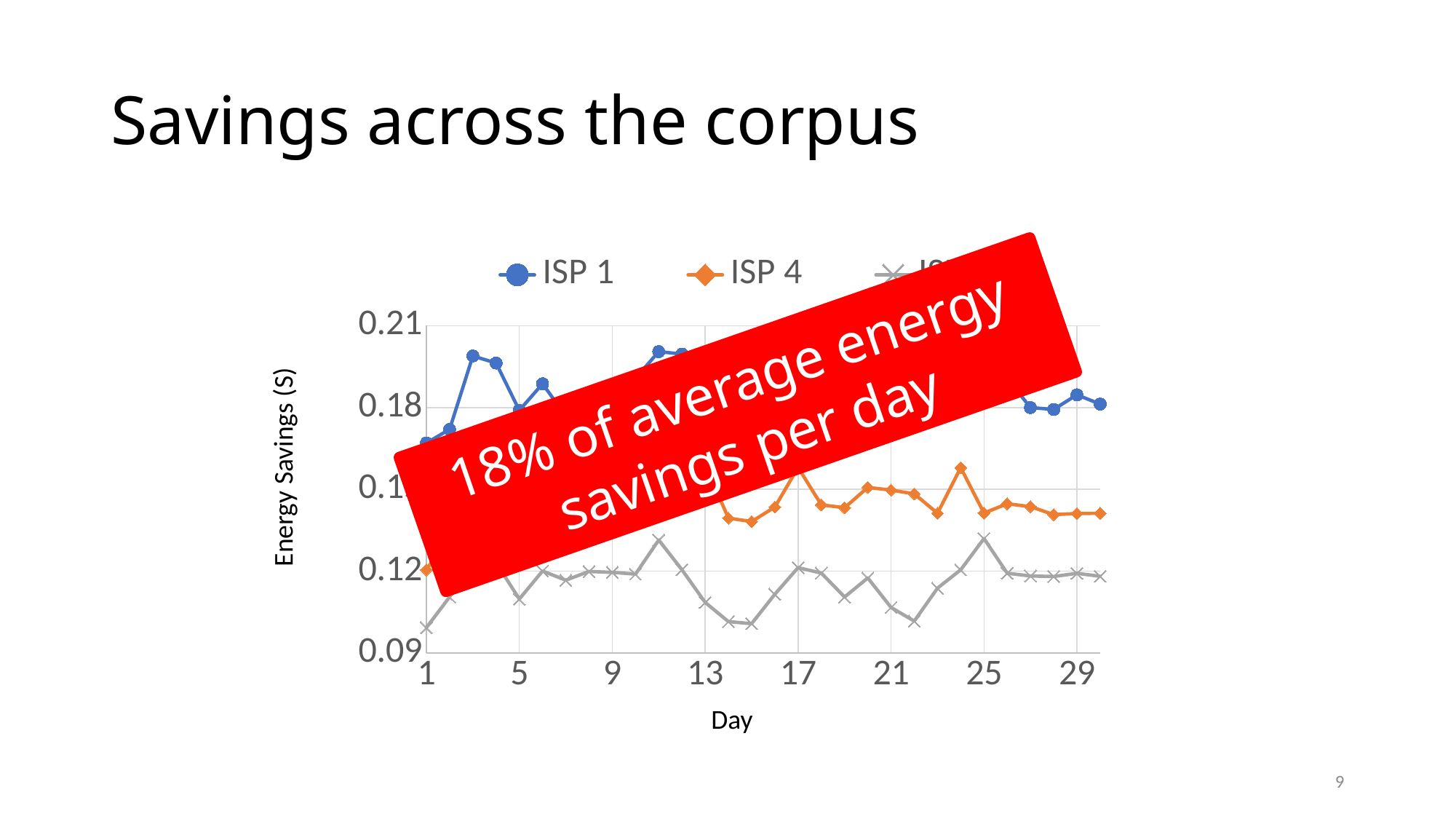
Is the value for ISP 1 on day 30 greater or less than 0.15? greater Is the value for ISP 4 on day 30 greater or less than 0.15? less Is the value for ISP 4 on day 15 greater or less than 0.15? less What is the label of the x axis? Day On day 30, which series has the larger value, ISP 1 or ISP 4? ISP 1 What kind of chart is shown on the slide? line chart Does the value for ISP 4 rise or fall from day 24 to day 30? fall What is the label of the y axis? Energy Savings (S) How many series does the chart's legend list? 3 How many days are plotted for each series? 30